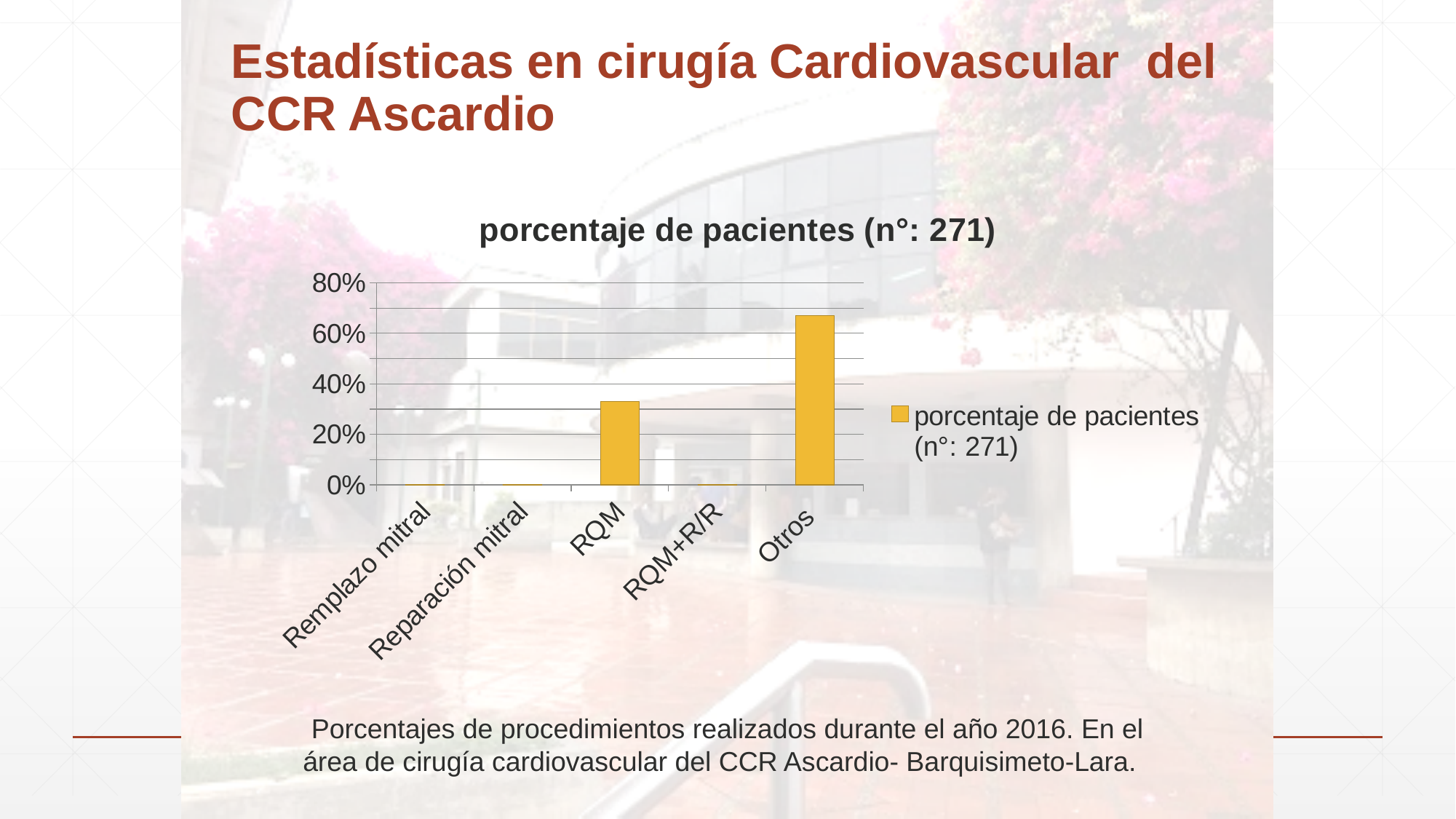
What is the title of the chart? porcentaje de pacientes (n°: 271) Is the value for Otros greater or less than 80%? less Is the value for RQM greater or less than 40%? less How many categories are shown on the x axis of the chart? 5 Which is larger, the value for RQM or the value for Otros? Otros What is the highest value shown on the chart's vertical axis? 80% How many series does the chart legend list? 1 Which category has the highest value in the chart? Otros Is the value for Remplazo mitral greater or less than 20%? less What kind of chart is shown on the slide? bar chart